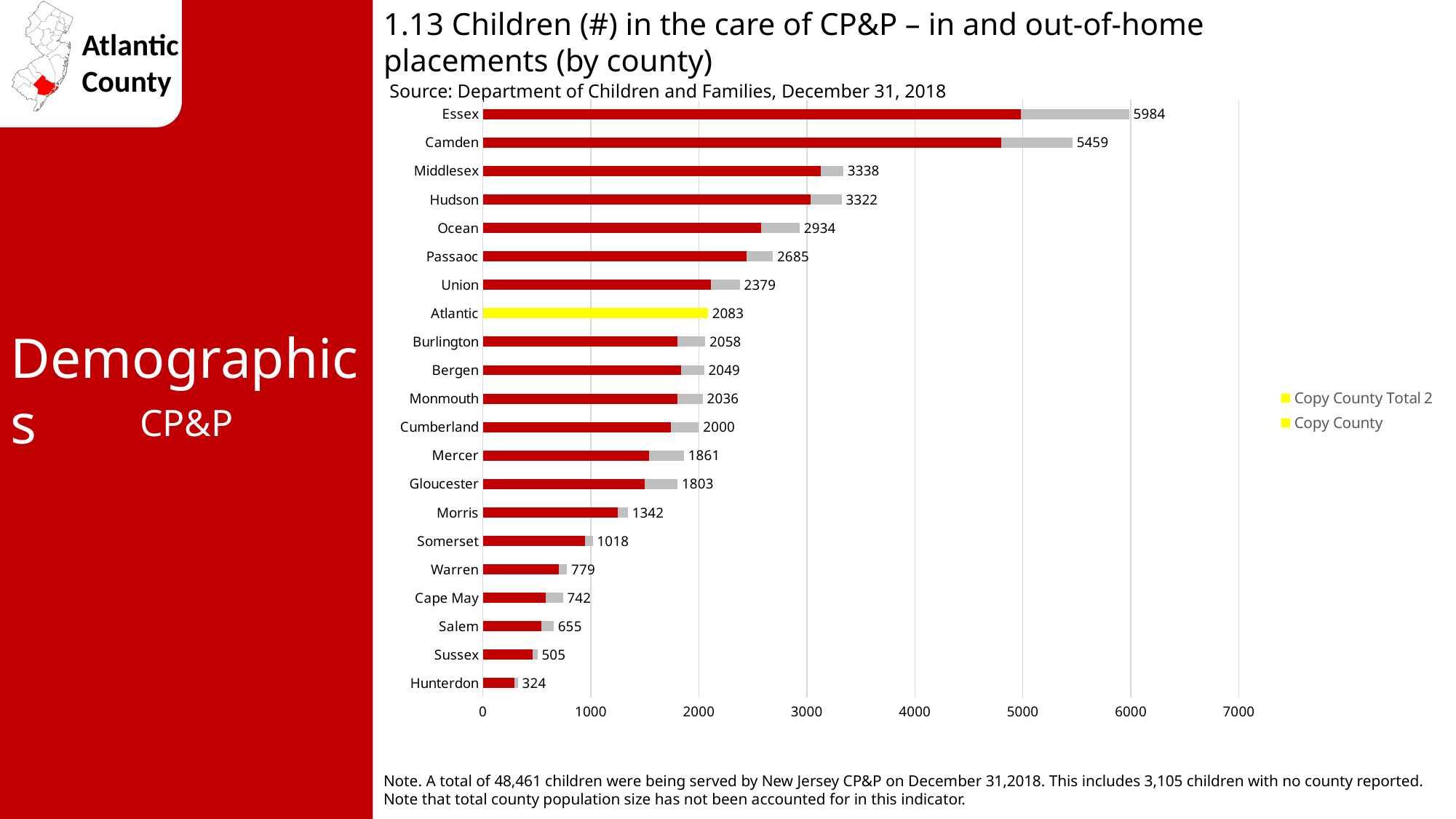
What value is shown for Hunterdon county? 324 What type of chart is shown on the slide? Bar chart What value is shown for Atlantic county? 2083 What is the difference between the values for Essex and Camden? 525 How many counties are shown in the chart? 21 Which county has a larger value, Ocean or Passaic? Ocean What is the total number of children in the care of CP&P for Essex county? 5984 What value is shown for Cumberland county? 2000 How many entries does the legend list? 2 Which county has the highest number of children in the care of CP&P? Essex Which county has the lowest number of children in the care of CP&P? Hunterdon What is the difference between the values for Atlantic and Burlington? 25